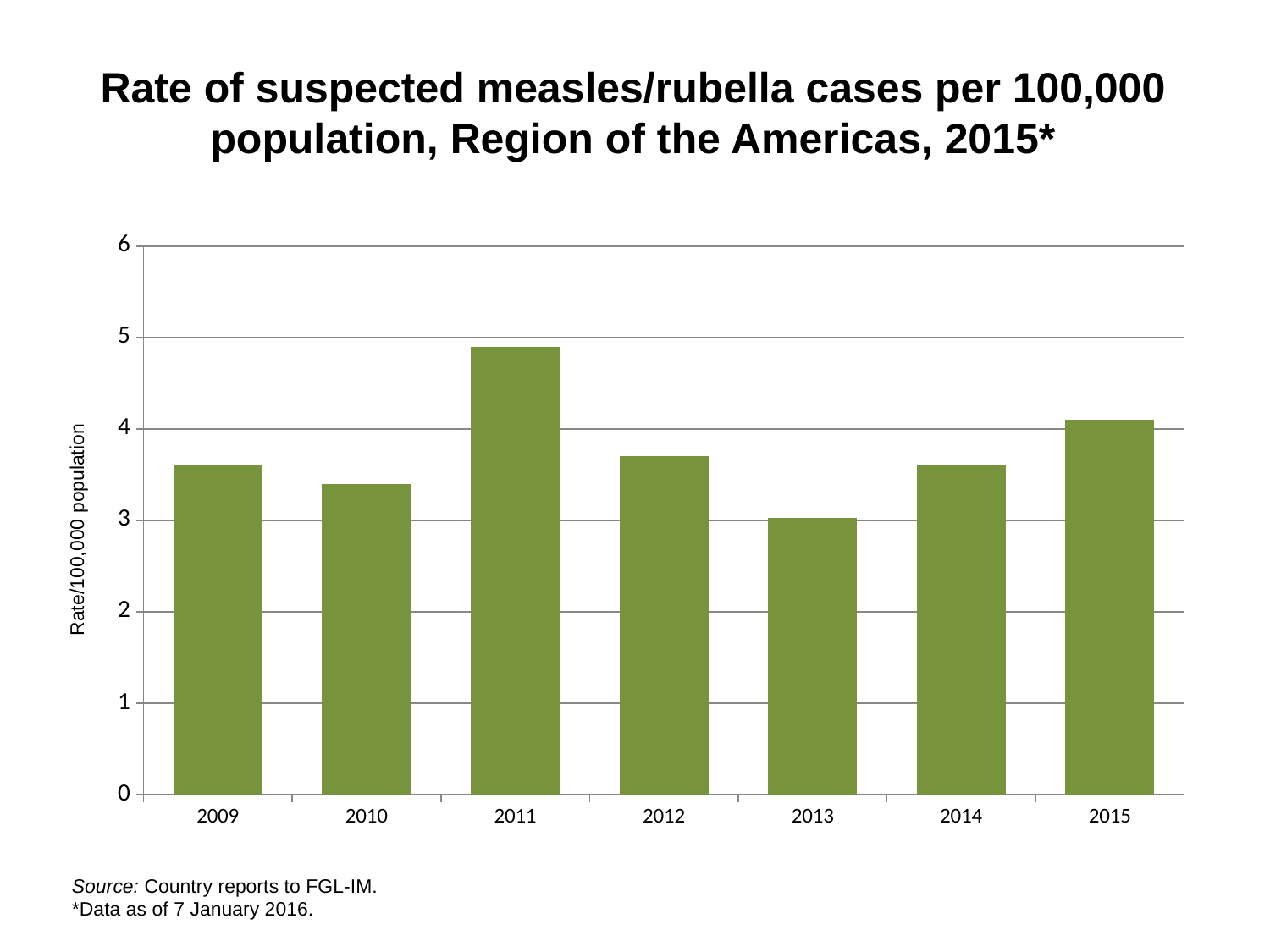
What kind of chart is shown on the slide? bar chart Is the value for 2011 greater or less than 4? greater Which year has the lowest rate of suspected measles/rubella cases? 2013 Is the value for 2010 greater or less than 4? less Is the value for 2011 greater or less than 5? less Which year has the larger value, 2011 or 2012? 2011 Which year has the larger value, 2010 or 2015? 2015 What is the label on the y axis of the chart? Rate/100,000 population How many years are shown on the x axis of the chart? 7 Which year has the highest rate of suspected measles/rubella cases? 2011